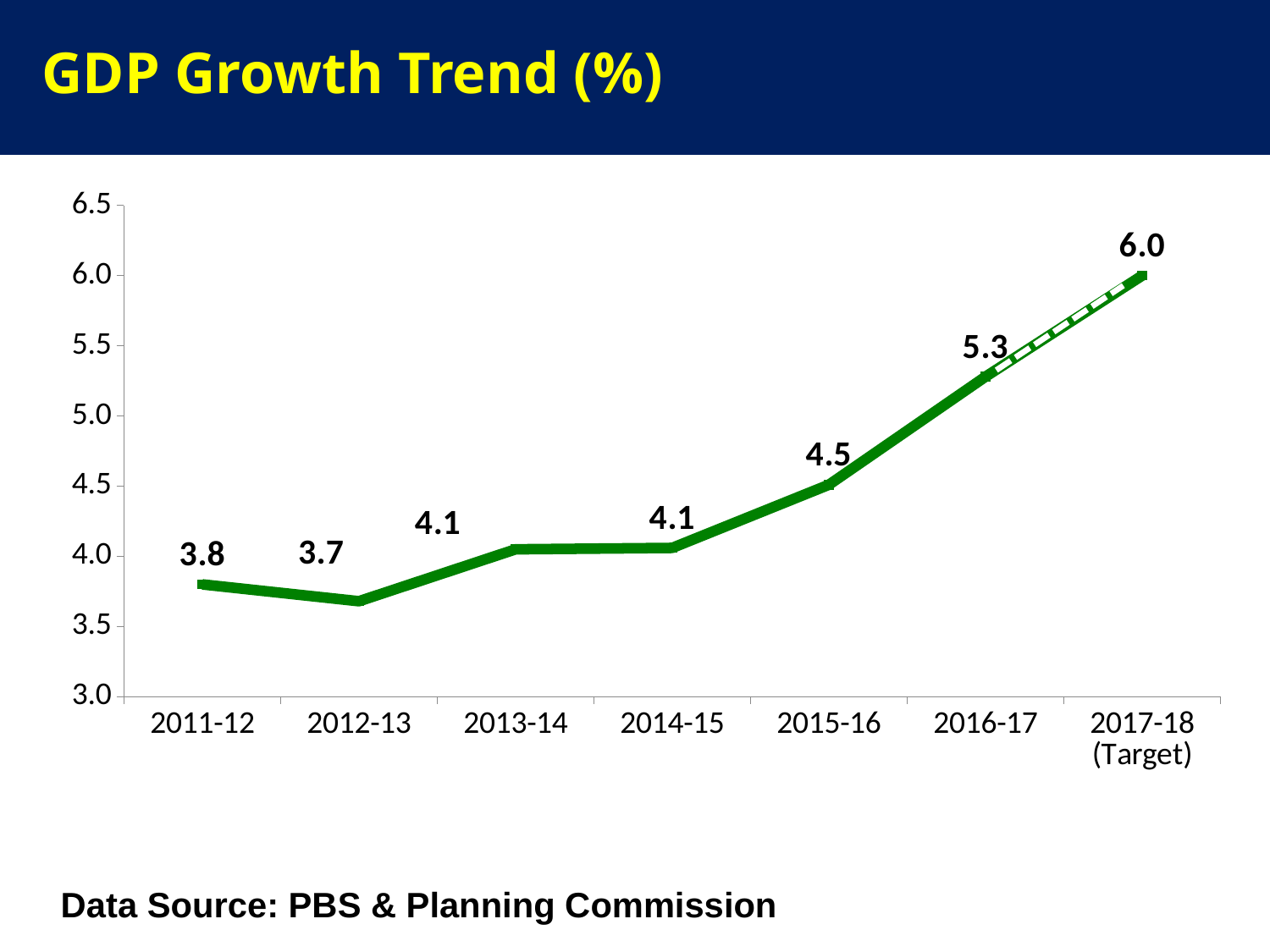
What is the GDP growth value for 2011-12? 3.8 Which year has the highest GDP growth value on the chart? 2017-18 (Target) How many years are plotted on the chart? 7 Do the GDP growth values generally rise or fall from 2012-13 to 2017-18? Rise Which is larger, the GDP growth value for 2012-13 or for 2014-15? 2014-15 What is the difference between the GDP growth values for 2016-17 and 2015-16? 0.8 What is the GDP growth value for 2015-16? 4.5 What is the title of the chart? GDP Growth Trend (%) What is the GDP growth target for 2017-18? 6.0 What kind of chart is shown on the slide? Line chart Is the GDP growth value for 2016-17 greater or less than 5.0? greater Which year has the lowest GDP growth value on the chart? 2012-13